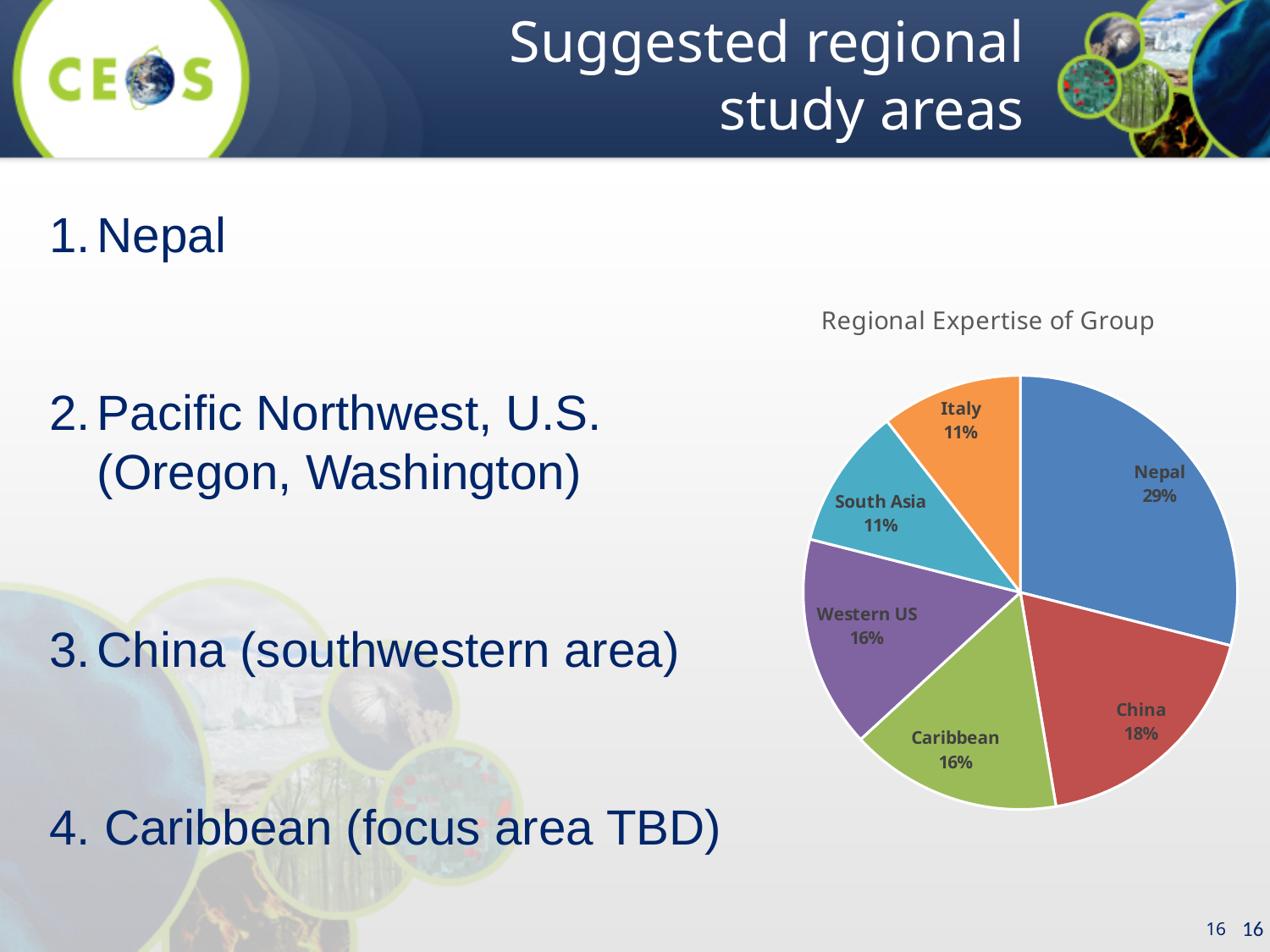
What share of the pie does Nepal hold in the Regional Expertise of Group chart? 29% Which is larger, the share for China or the share for Caribbean? China What percentage is shown for South Asia? 11% Which region has the largest slice of the pie chart? Nepal What kind of chart is shown on the slide? Pie chart What is the difference in percentage points between Nepal and China? 11 What is the title of the chart? Regional Expertise of Group What is the value shown for China in the pie chart? 18% What percentage is shown for Western US? 16% What is the combined share of Italy and South Asia? 22% How many slices does the pie chart have? 6